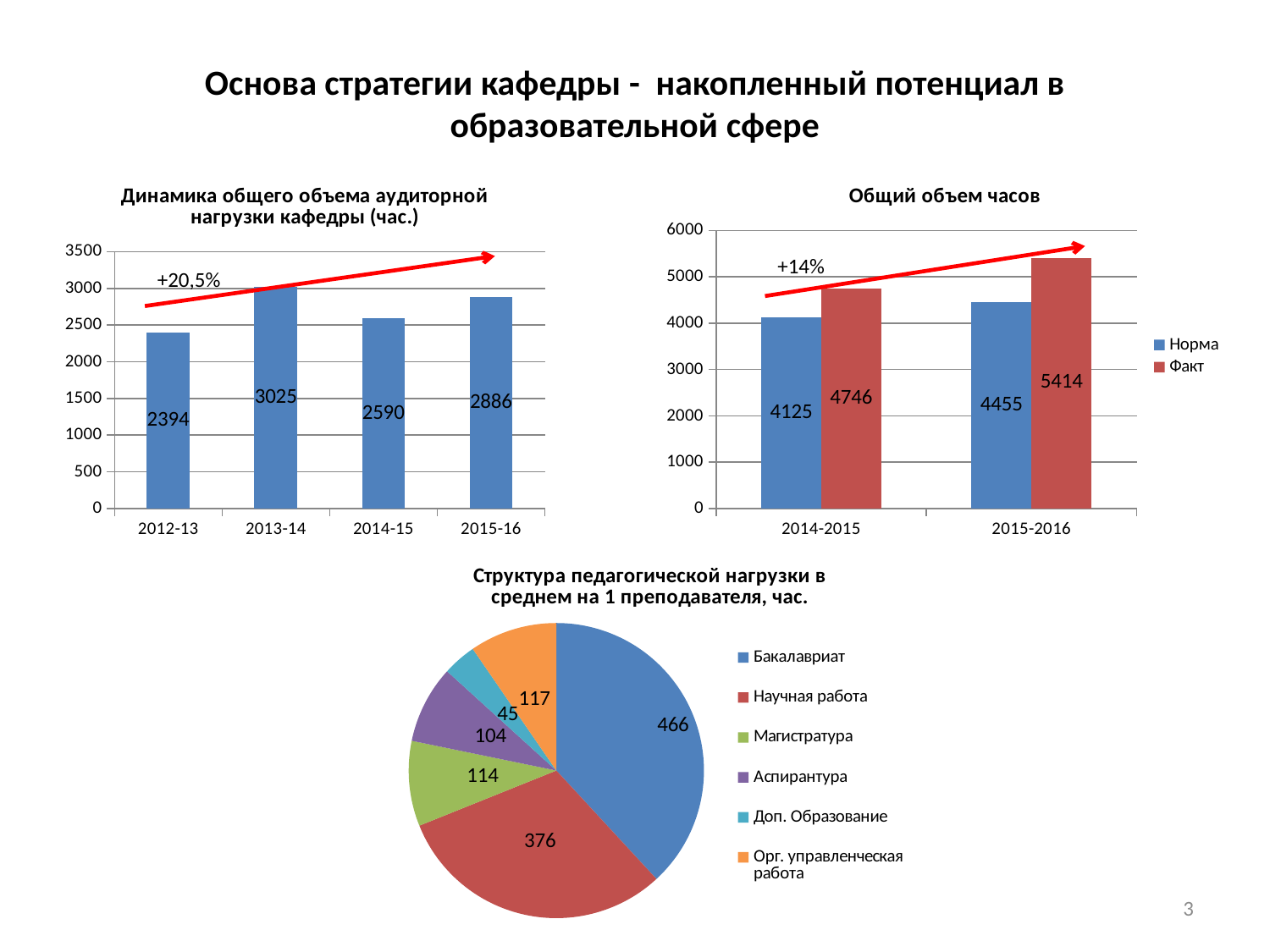
In the chart 'Общий объем часов', what is the value of Факт for 2015-2016? 5414 In the chart 'Динамика общего объема аудиторной нагрузки кафедры (час.)', which year has the lowest value? 2012-13 What kind of chart is 'Структура педагогической нагрузки в среднем на 1 преподавателя, час.'? pie chart In the chart 'Общий объем часов', which is larger for 2014-2015: Норма or Факт? Факт In the chart 'Динамика общего объема аудиторной нагрузки кафедры (час.)', what is the value for 2013-14? 3025 In the pie chart 'Структура педагогической нагрузки в среднем на 1 преподавателя, час.', what is the value for Научная работа? 376 How many series does the legend of the chart 'Общий объем часов' list? 2 In the pie chart 'Структура педагогической нагрузки в среднем на 1 преподавателя, час.', which category has the smallest slice? Доп. Образование In the chart 'Общий объем часов', what is the difference between Факт and Норма for 2015-2016? 959 In the chart 'Динамика общего объема аудиторной нагрузки кафедры (час.)', what is the difference between the values for 2015-16 and 2014-15? 296 In the chart 'Общий объем часов', what is the value of Норма for 2014-2015? 4125 How many categories are shown on the x axis of the chart 'Динамика общего объема аудиторной нагрузки кафедры (час.)'? 4